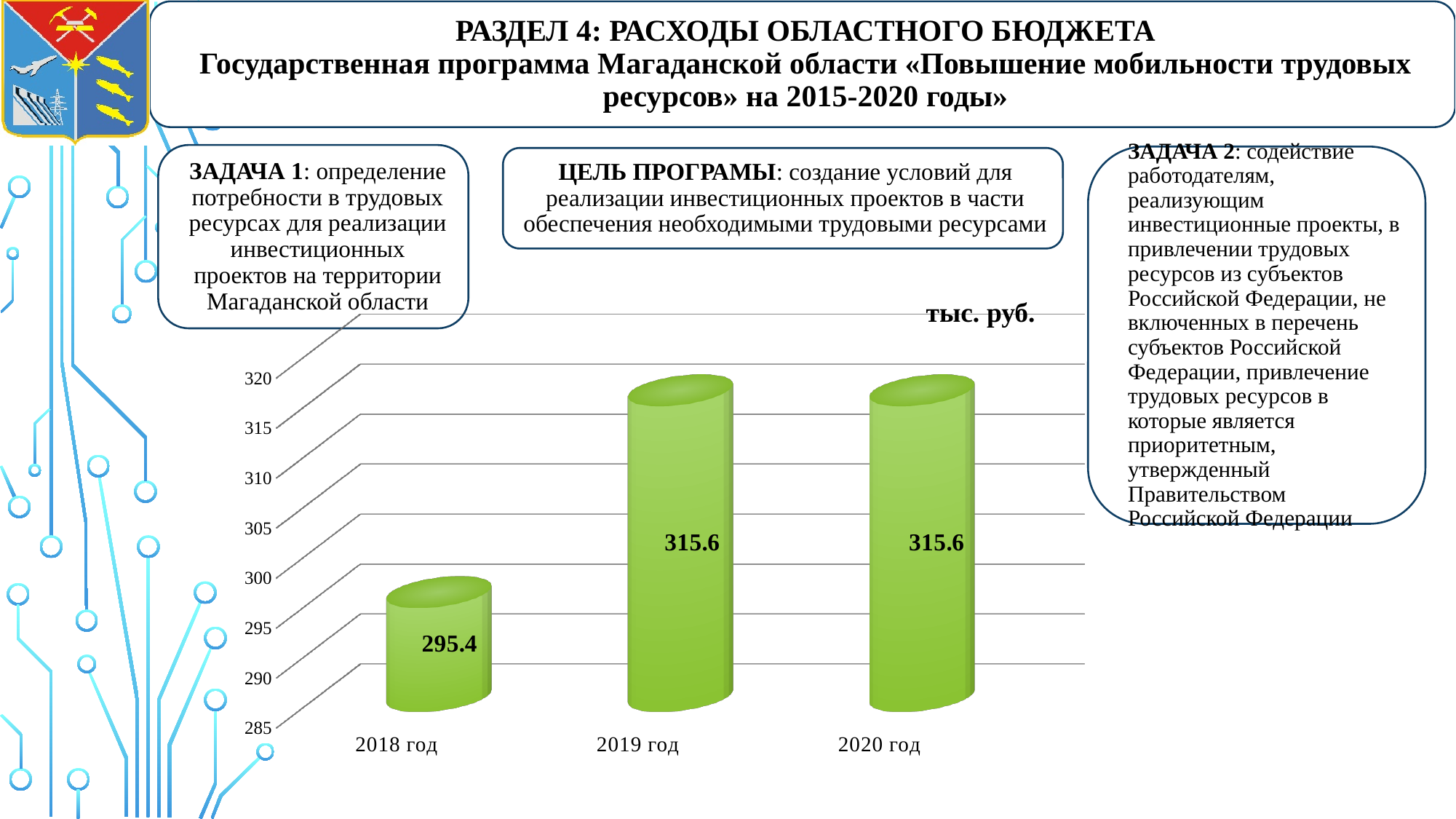
What is the value for 2020 год? 315.6 What kind of chart is shown on the slide? bar chart Which is larger, the value for 2018 год or the value for 2020 год? 2020 год What unit is indicated above the chart? тыс. руб. Is the value for 2019 год greater or less than 310? greater How many years are shown on the chart? 3 Which year has the lowest value? 2018 год What is the difference between the values for 2019 год and 2018 год? 20.2 What is the value for 2019 год? 315.6 What is the value for 2018 год? 295.4 Do the values rise or fall from 2018 год to 2019 год? rise Is the value for 2018 год greater or less than 300? less